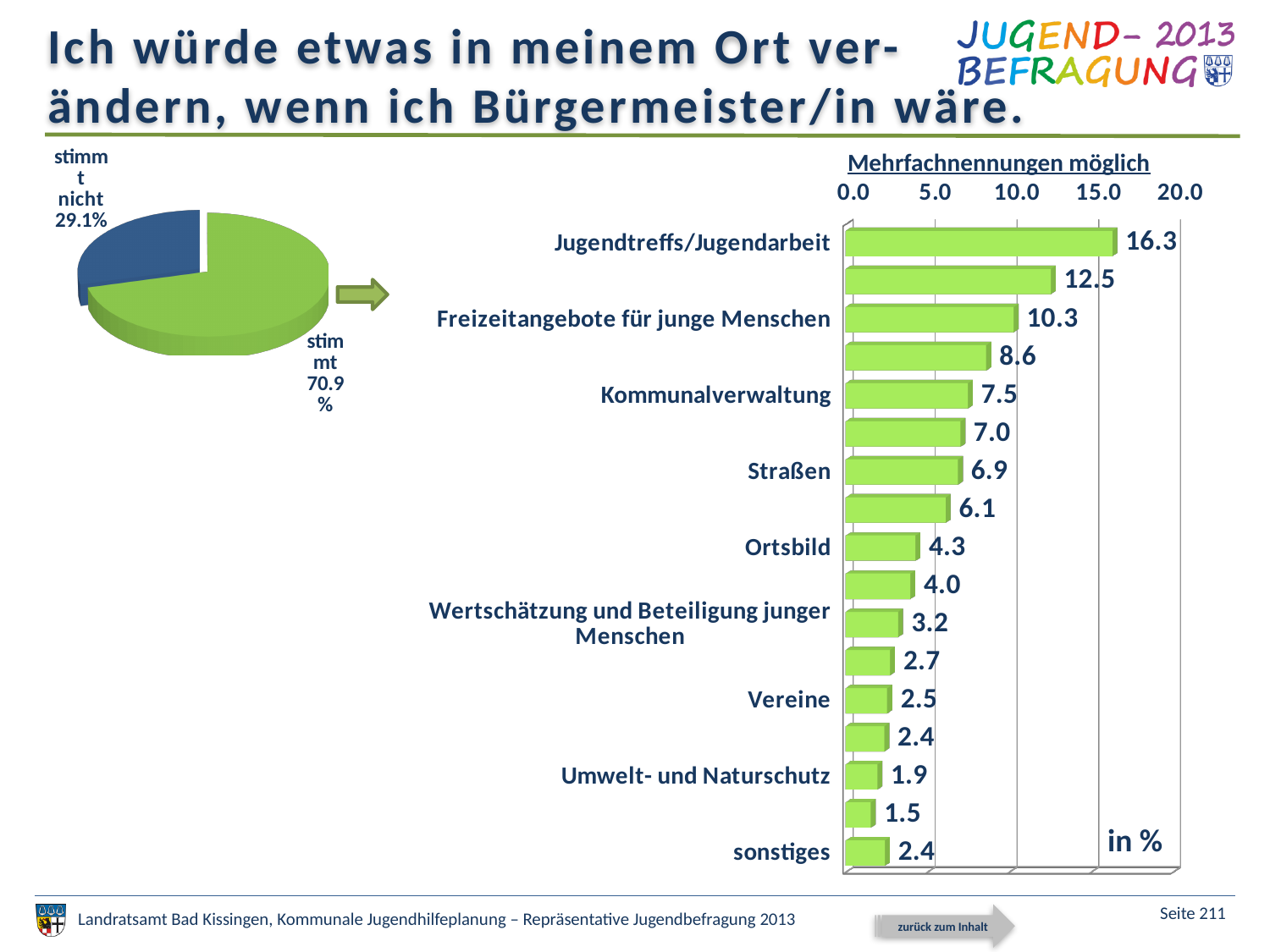
In the bar chart on the right, which category has the highest value? Jugendtreffs/Jugendarbeit In the pie chart on the left, what percentage is shown for "stimmt"? 70.9% In the bar chart on the right, what is the value for Jugendtreffs/Jugendarbeit? 16.3 What kind of chart is the chart on the right of the slide? bar chart What kind of chart is the chart on the left of the slide? pie chart In the bar chart on the right, what is the difference between the values for Jugendtreffs/Jugendarbeit and Freizeitangebote für junge Menschen? 6.0 In the bar chart on the right, which has the larger value, Straßen or Ortsbild? Straßen How many bars are plotted in the bar chart on the right? 17 In the pie chart on the left, what percentage is shown for "stimmt nicht"? 29.1% In the bar chart on the right, what is the value for Kommunalverwaltung? 7.5 In the pie chart on the left, which slice is larger, "stimmt" or "stimmt nicht"? stimmt In the bar chart on the right, what is the value for Umwelt- und Naturschutz? 1.9